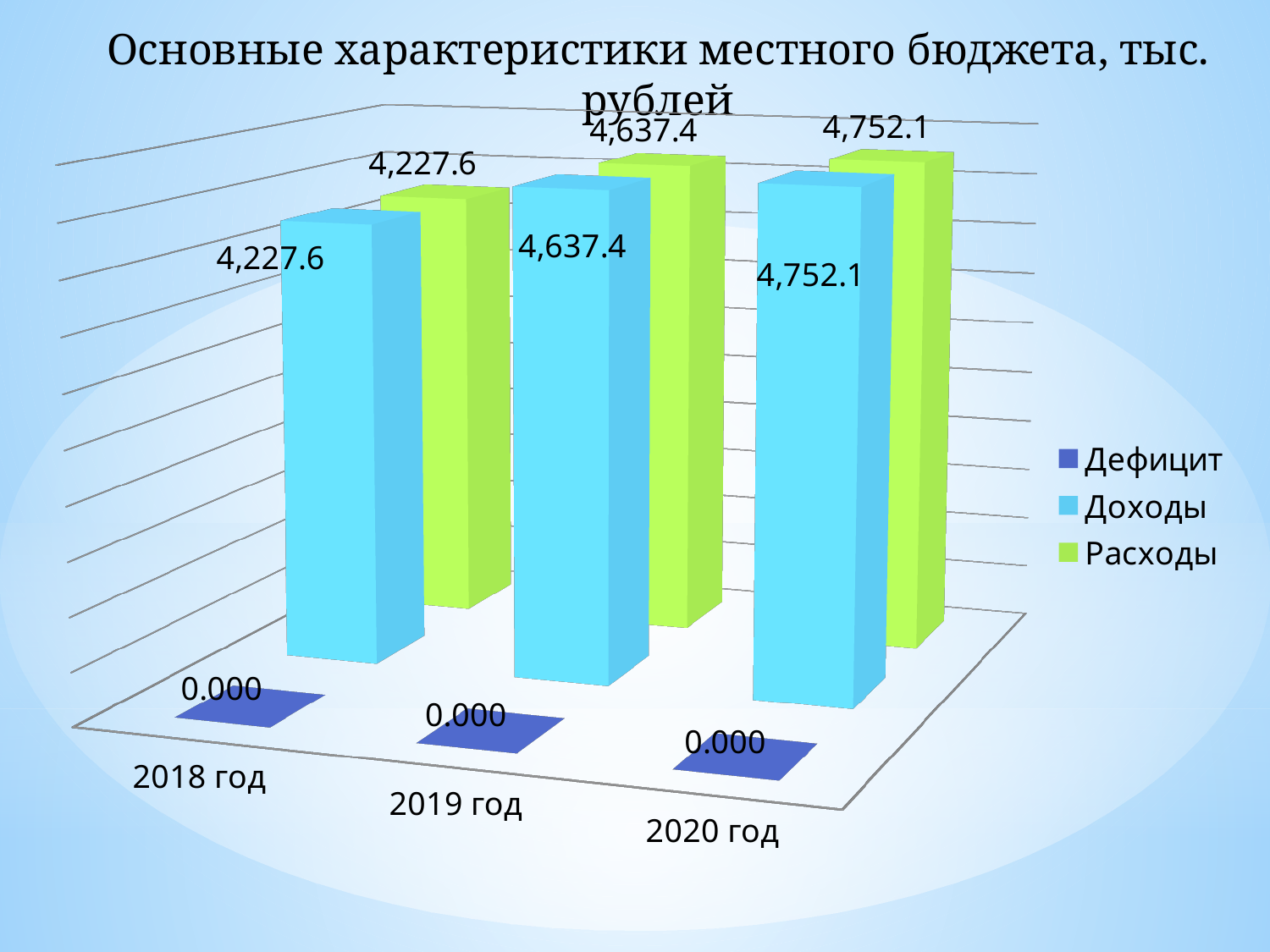
What is the difference between Доходы in 2019 год and Доходы in 2018 год? 409.8 How many years are shown on the x axis? 3 What is the value of Дефицит for 2019 год? 0.000 What is the value of Расходы for 2020 год? 4,752.1 Which is larger: Доходы in 2020 год or Доходы in 2018 год? Доходы in 2020 год How many series does the legend list? 3 What is the value of Доходы for 2018 год? 4,227.6 In which year is Расходы lowest? 2018 год Do the Доходы values rise or fall from 2018 год to 2020 год? rise What is the value of Расходы for 2019 год? 4,637.4 In which year is Доходы highest? 2020 год What is the difference between Расходы in 2020 год and Расходы in 2018 год? 524.5